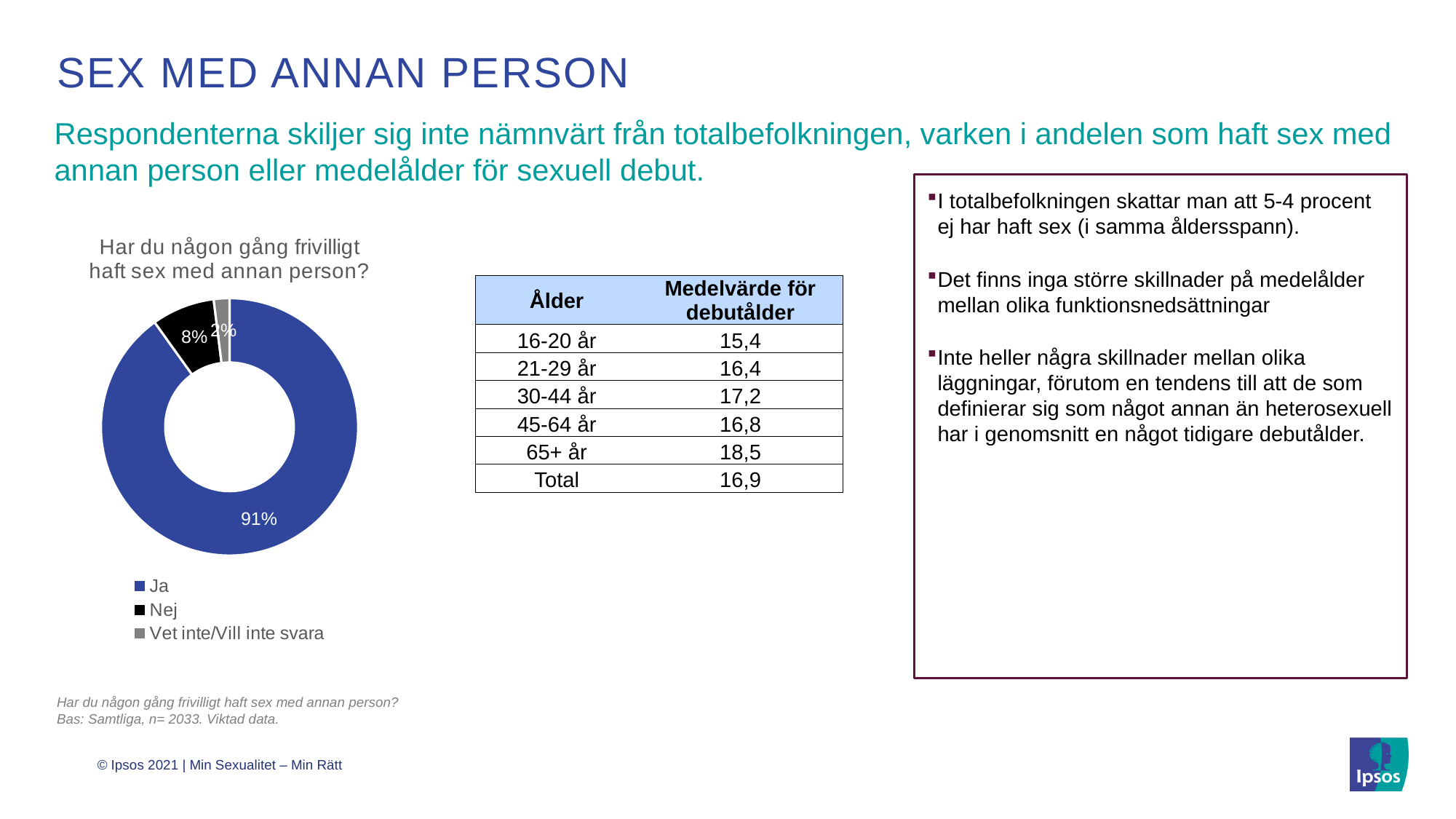
Which response has the largest share in the donut chart? Ja How many response categories are shown in the donut chart? 3 What is the difference in percentage points between the "Ja" and "Nej" shares in the donut chart? 83 percentage points What percentage of respondents answered "Nej" in the donut chart? 8% What type of chart is used to show the responses to "Har du någon gång frivilligt haft sex med annan person?"? Pie (donut) chart What percentage of respondents answered "Vet inte/Vill inte svara" in the donut chart? 2% Which is larger in the donut chart, the share for "Nej" or the share for "Vet inte/Vill inte svara"? Nej Which response has the smallest share in the donut chart? Vet inte/Vill inte svara What percentage of respondents answered "Ja" in the donut chart? 91% What is the title of the donut chart? Har du någon gång frivilligt haft sex med annan person? How many entries does the legend of the donut chart list? 3 What colour represents "Nej" in the donut chart? Black